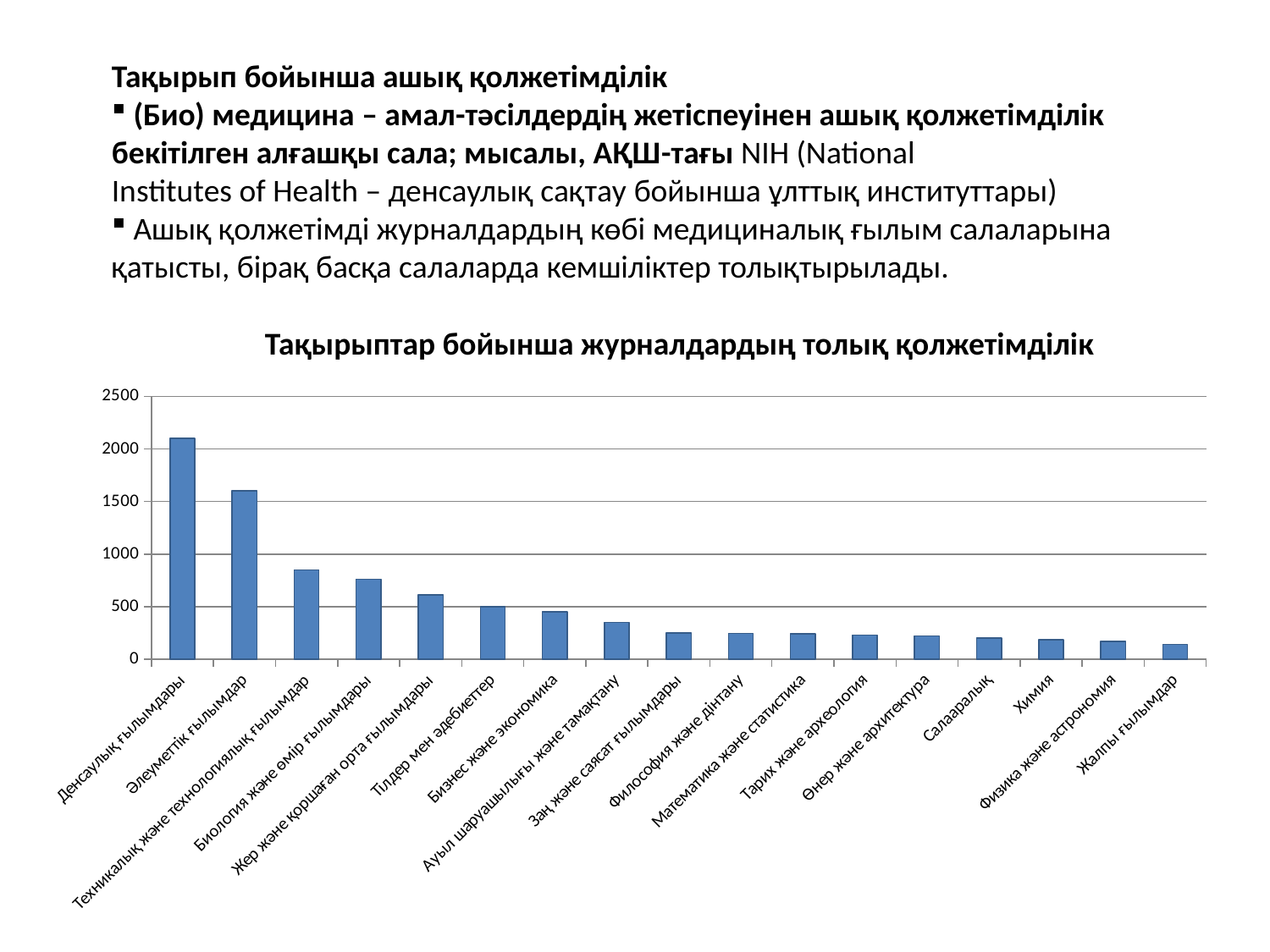
What kind of chart is shown on the slide? Bar chart Is the value for Биология және өмір ғылымдары greater or less than 500? greater Is the value for Әлеуметтік ғылымдар greater or less than 1500? greater How many categories are shown on the x axis of the chart? 17 What is the title of the chart? Тақырыптар бойынша журналдардың толық қолжетімділік Is the value for Денсаулық ғылымдары greater or less than 2000? greater Do the values rise or fall moving from left to right along the x axis? Fall Which is larger, the value for Денсаулық ғылымдары or the value for Әлеуметтік ғылымдар? Денсаулық ғылымдары Which category has the lowest value in the chart? Жалпы ғылымдар Which category has the highest value in the chart? Денсаулық ғылымдары